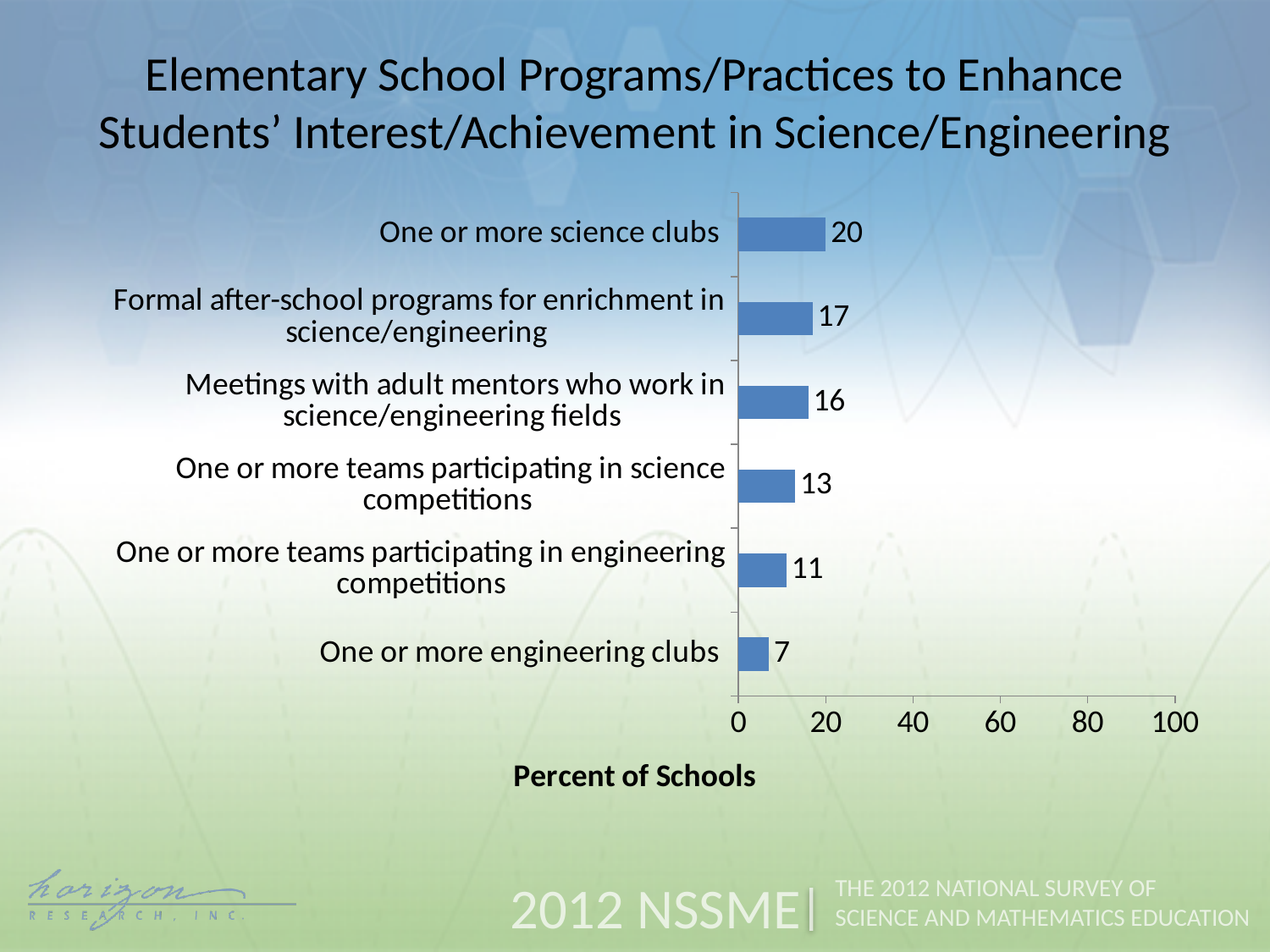
Which category has the highest percent of schools? One or more science clubs What is the value for 'Meetings with adult mentors who work in science/engineering fields'? 16 Which category has the lowest percent of schools? One or more engineering clubs What percent of schools have one or more science clubs? 20 What kind of chart is shown on the slide? Bar chart How many categories are shown in the chart? 6 Is the value for 'One or more science clubs' greater or less than 40? less What is the difference between the values for 'One or more science clubs' and 'One or more engineering clubs'? 13 What percent of schools have formal after-school programs for enrichment in science/engineering? 17 What is the label of the horizontal axis? Percent of Schools What is the value for 'One or more engineering clubs'? 7 Which is larger: the value for teams participating in science competitions or teams participating in engineering competitions? One or more teams participating in science competitions